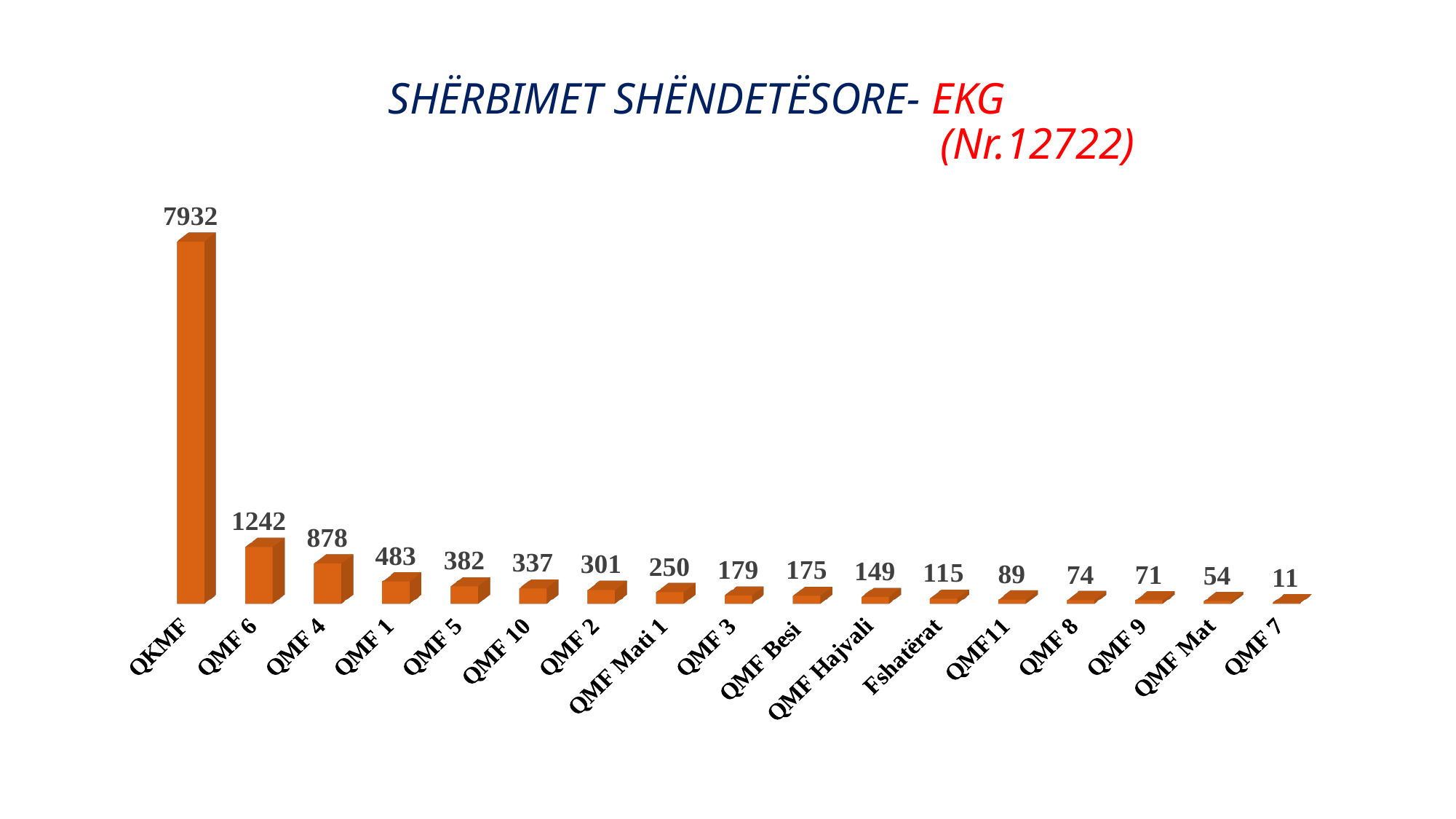
What kind of chart is shown on the slide? Bar chart What is the value for QKMF? 7932 Which category has the lowest value? QMF 7 What is the value for QMF Mat? 54 What is the difference between the values for QKMF and QMF 6? 6690 What is the value for QMF Hajvali? 149 Which category has the highest value? QKMF What is the difference between the values for QMF 6 and QMF 4? 364 How many categories are shown on the chart? 17 Which is larger, the value for QMF 1 or the value for QMF 5? QMF 1 What is the value for Fshatërat? 115 What total number is shown in the chart title? 12722